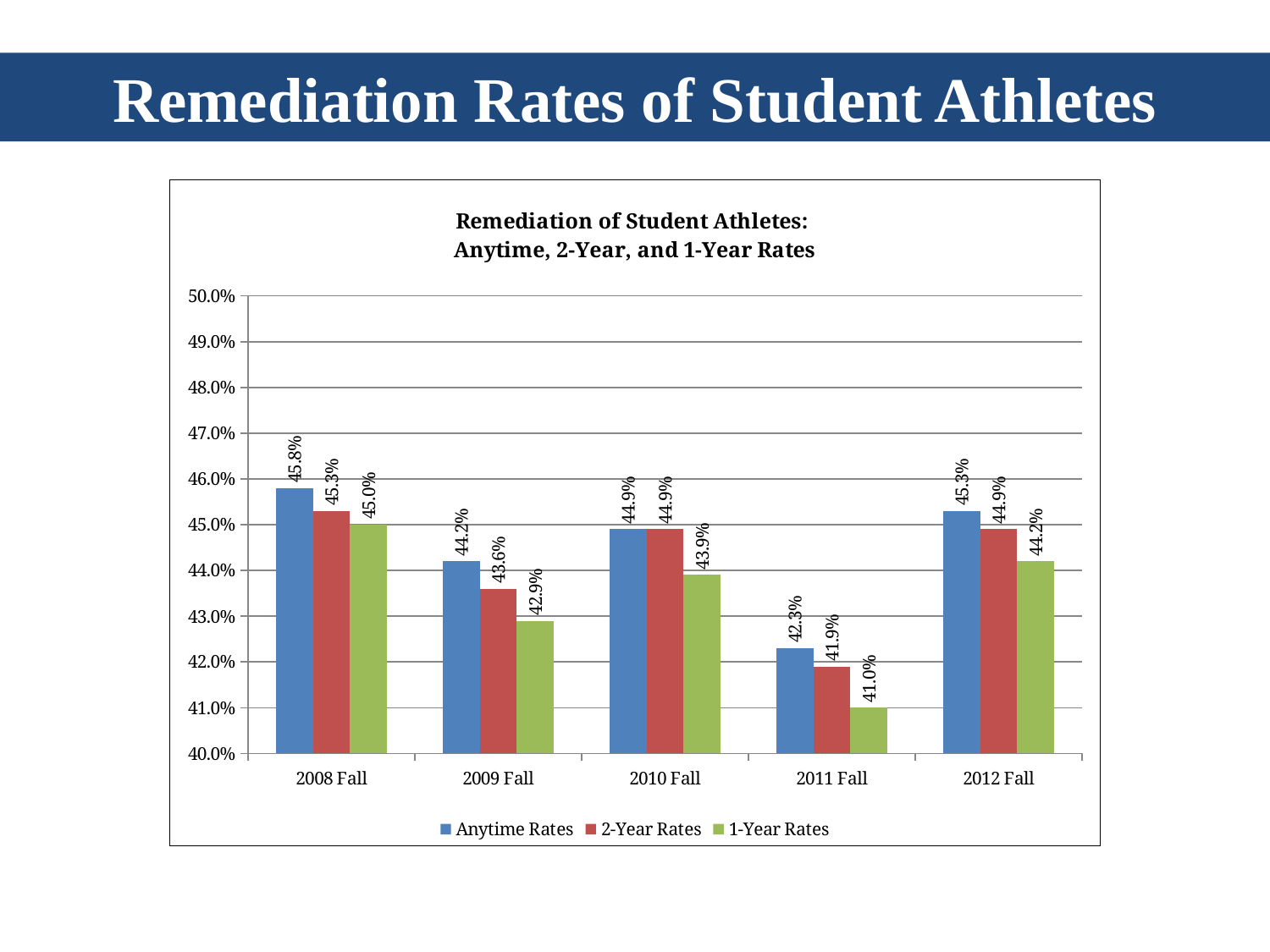
What is the Anytime Rate for 2008 Fall? 45.8% How many years are shown on the x axis? 5 Is the 1-Year Rate for 2012 Fall greater or less than 44.0%? greater Which year has the highest 1-Year Rate? 2008 Fall Which colour represents the 2-Year Rates series? red What is the difference between the Anytime Rate and the 1-Year Rate for 2011 Fall? 1.3% What is the 1-Year Rate for 2011 Fall? 41.0% How many series does the legend list? 3 Which is larger, the 2-Year Rate for 2010 Fall or the 2-Year Rate for 2009 Fall? 2010 Fall Which year has the lowest Anytime Rate? 2011 Fall What kind of chart is shown? bar chart What is the 2-Year Rate for 2009 Fall? 43.6%